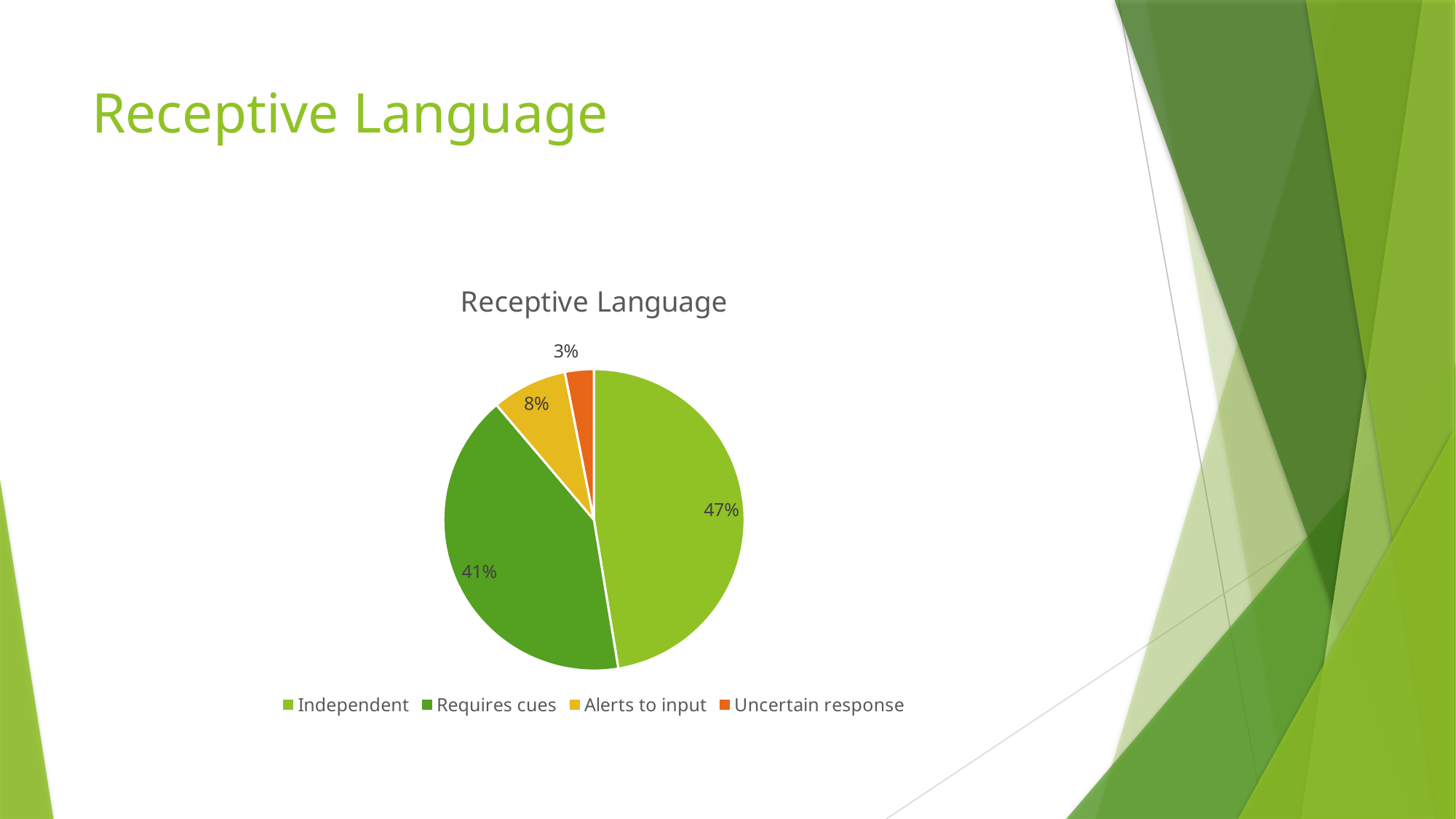
What is the title of the chart? Receptive Language Which category has the largest slice of the pie? Independent What percentage of the pie is labelled Uncertain response? 3% What percentage of the pie is labelled Independent? 47% What percentage of the pie is labelled Requires cues? 41% How many categories does the legend list? 4 What percentage of the pie is labelled Alerts to input? 8% Which category has the smallest slice of the pie? Uncertain response What kind of chart is shown on the slide? pie chart Which is larger, the Alerts to input slice or the Uncertain response slice? Alerts to input What is the difference in percentage points between Independent and Requires cues? 6 What colour is the Uncertain response slice? orange